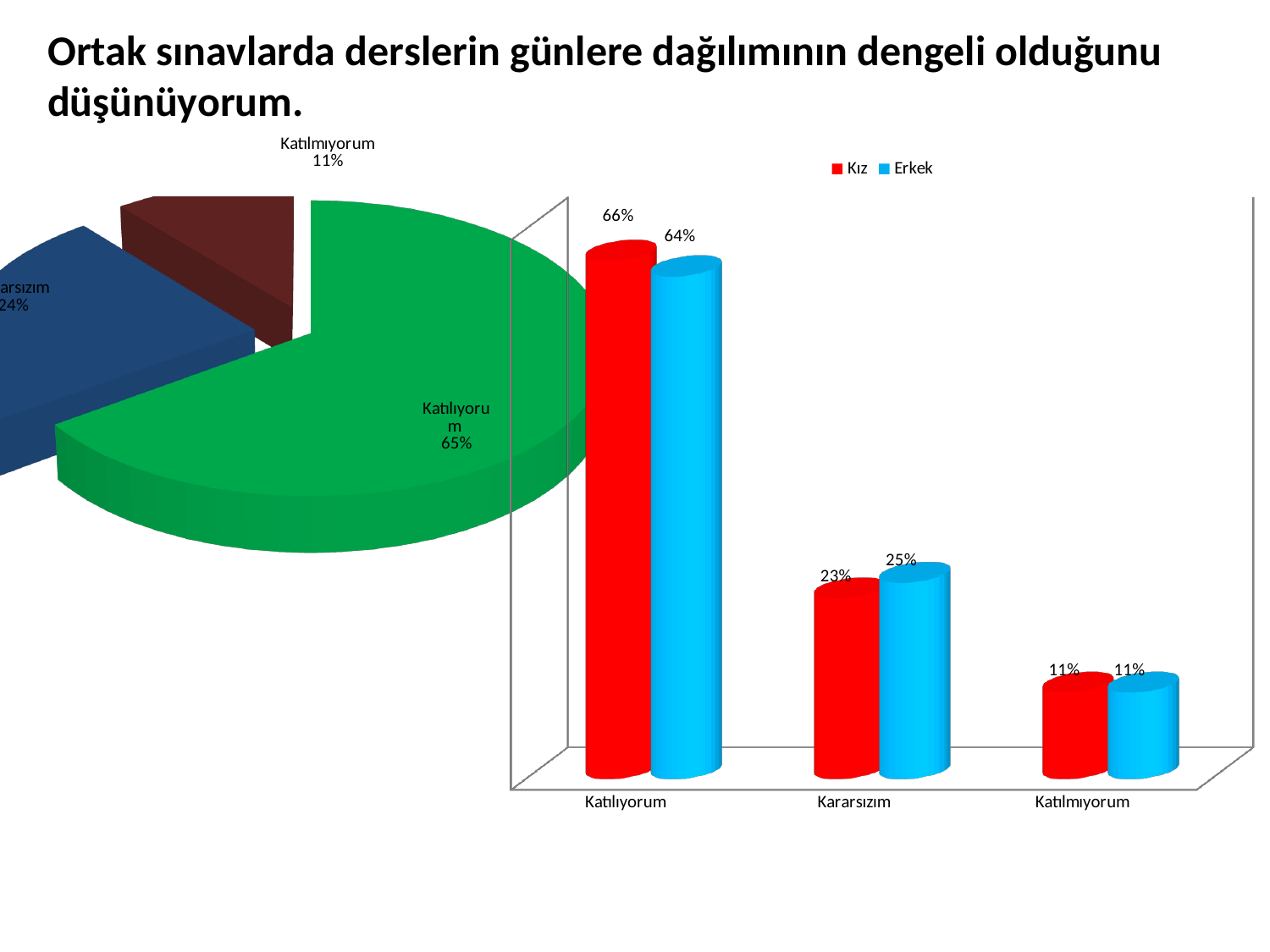
In the pie chart on the left, what share does the Katılıyorum slice have? 65% In the bar chart on the right, how many categories are shown on the x axis? 3 In the bar chart on the right, what is the Kız value for Katılıyorum? 66% In the bar chart on the right, which series is shown in red? Kız In the pie chart on the left, what share does the Katılmıyorum slice have? 11% In the bar chart on the right, what is the Erkek value for Kararsızım? 25% In the bar chart on the right, what is the difference between the Kız and Erkek values for Katılıyorum? 2% What kind of chart is the chart on the left of the slide? Pie chart What kind of chart is the chart on the right of the slide? Bar chart In the bar chart on the right, how many series does the legend list? 2 In the pie chart on the left, which slice is the smallest? Katılmıyorum In the pie chart on the left, which slice is the largest? Katılıyorum